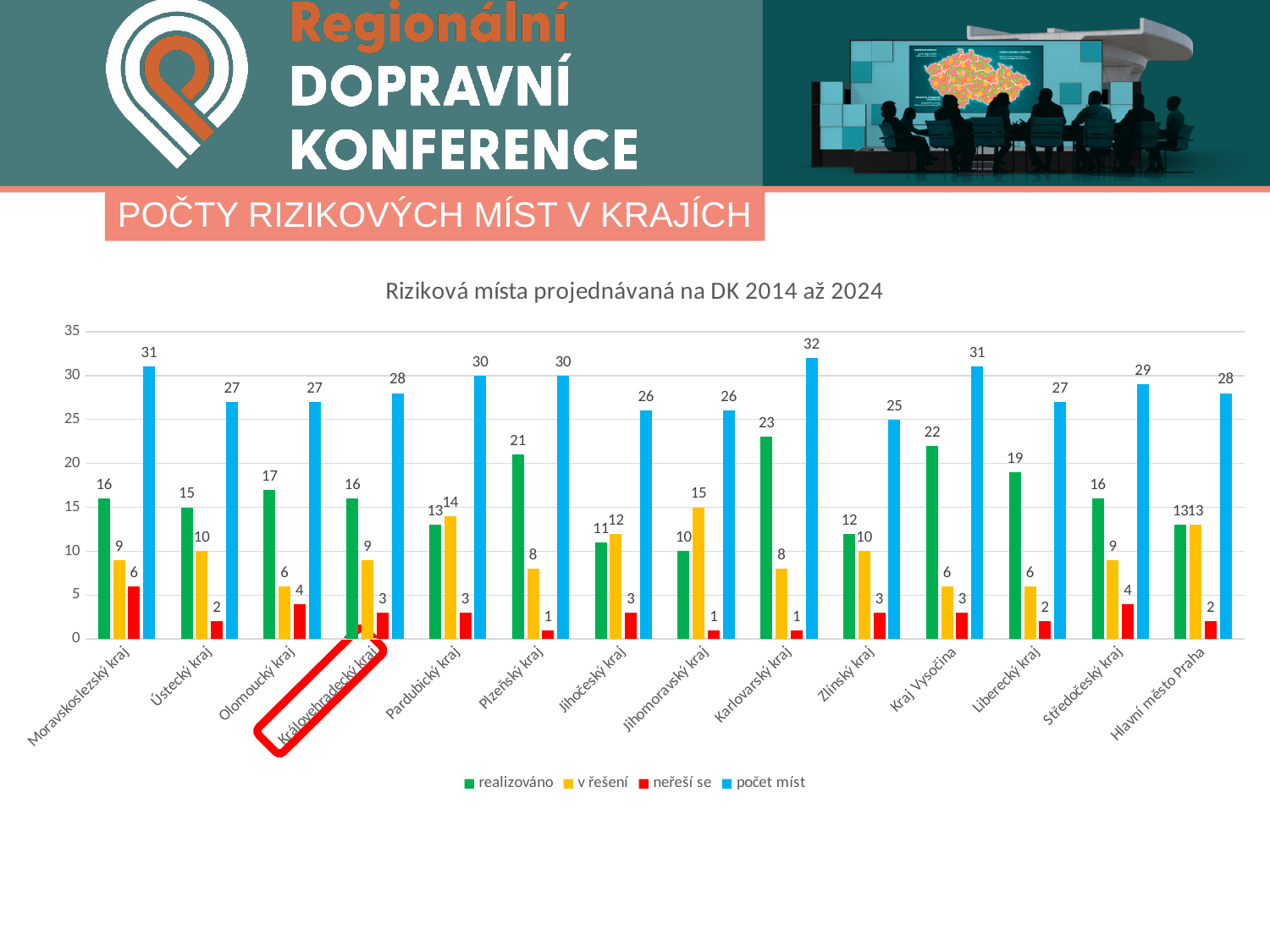
Which region has the highest 'počet míst' value? Karlovarský kraj Which is larger for Pardubický kraj: 'realizováno' or 'v řešení'? v řešení What type of chart is shown on the slide? Bar chart What is the 'realizováno' value for Plzeňský kraj? 21 What is the value of 'počet míst' for Karlovarský kraj? 32 How many series does the legend list? 4 Which region has the highest 'realizováno' value? Karlovarský kraj What is the 'v řešení' value for Jihomoravský kraj? 15 What is the difference between 'počet míst' and 'realizováno' for Kraj Vysočina? 9 How many regions (categories) are shown on the x axis? 14 Which region has the lowest 'počet míst' value? Zlínský kraj What is the 'neřeší se' value for Moravskoslezský kraj? 6